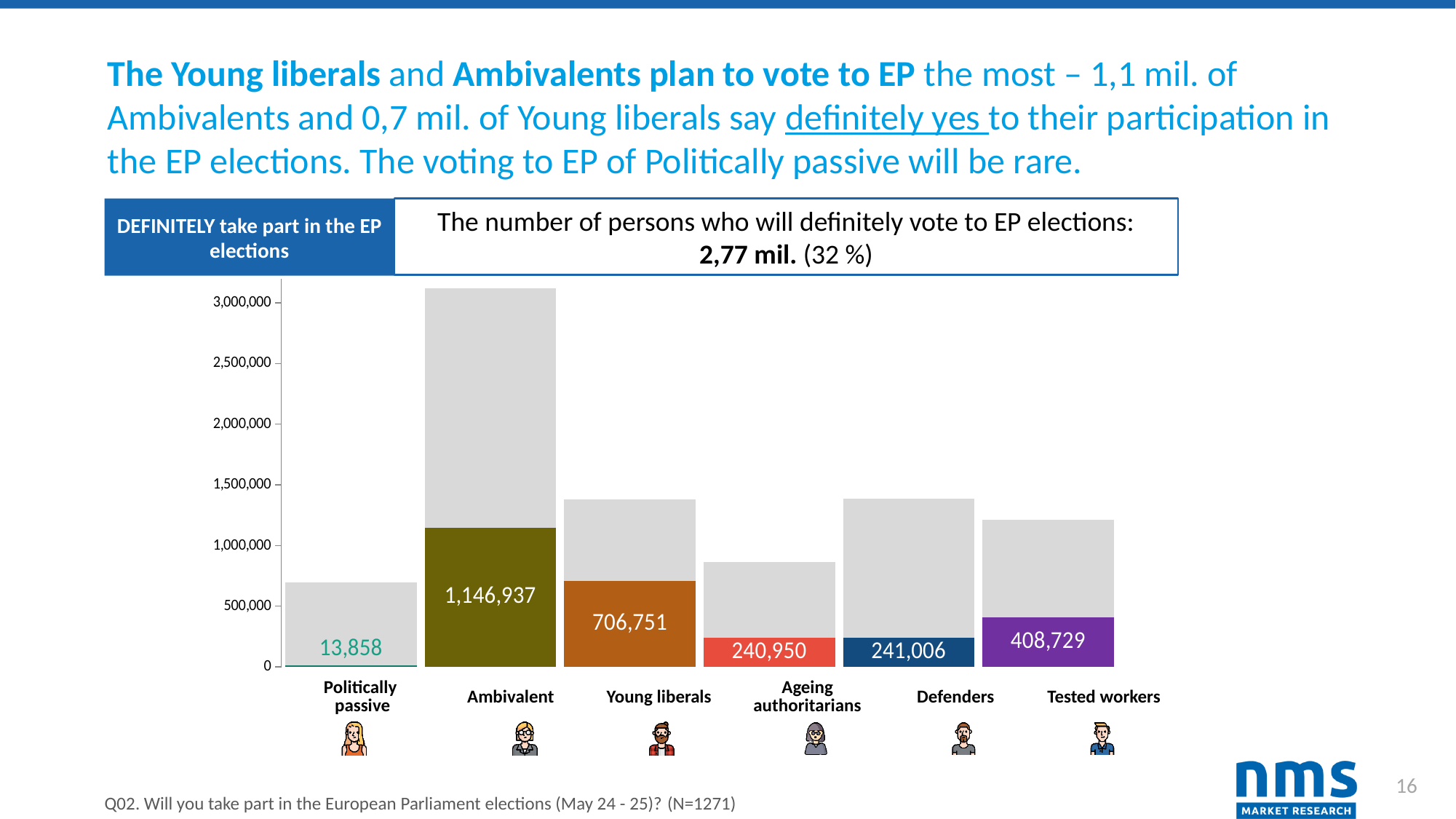
What is the value shown for Tested workers who will definitely take part in the EP elections? 408,729 What is the value shown for Politically passive who will definitely take part in the EP elections? 13,858 Which is larger: the value for Tested workers or the value for Young liberals? Young liberals What is the value shown for Young liberals who will definitely take part in the EP elections? 706,751 What kind of chart is shown on the slide? bar chart Which segment has the highest number of persons who will definitely take part in the EP elections? Ambivalent What is the difference between the Defenders and Ageing authoritarians values for definitely taking part in the EP elections? 56 What is the difference between the Ambivalent and Young liberals values for definitely taking part in the EP elections? 440,186 What is the number of persons in the Ambivalent segment who will definitely take part in the EP elections? 1,146,937 Is the total (grey) bar for Ambivalent greater or less than 3,000,000? greater Which segment has the lowest number of persons who will definitely take part in the EP elections? Politically passive How many segments (categories) are shown on the x axis of the chart? 6